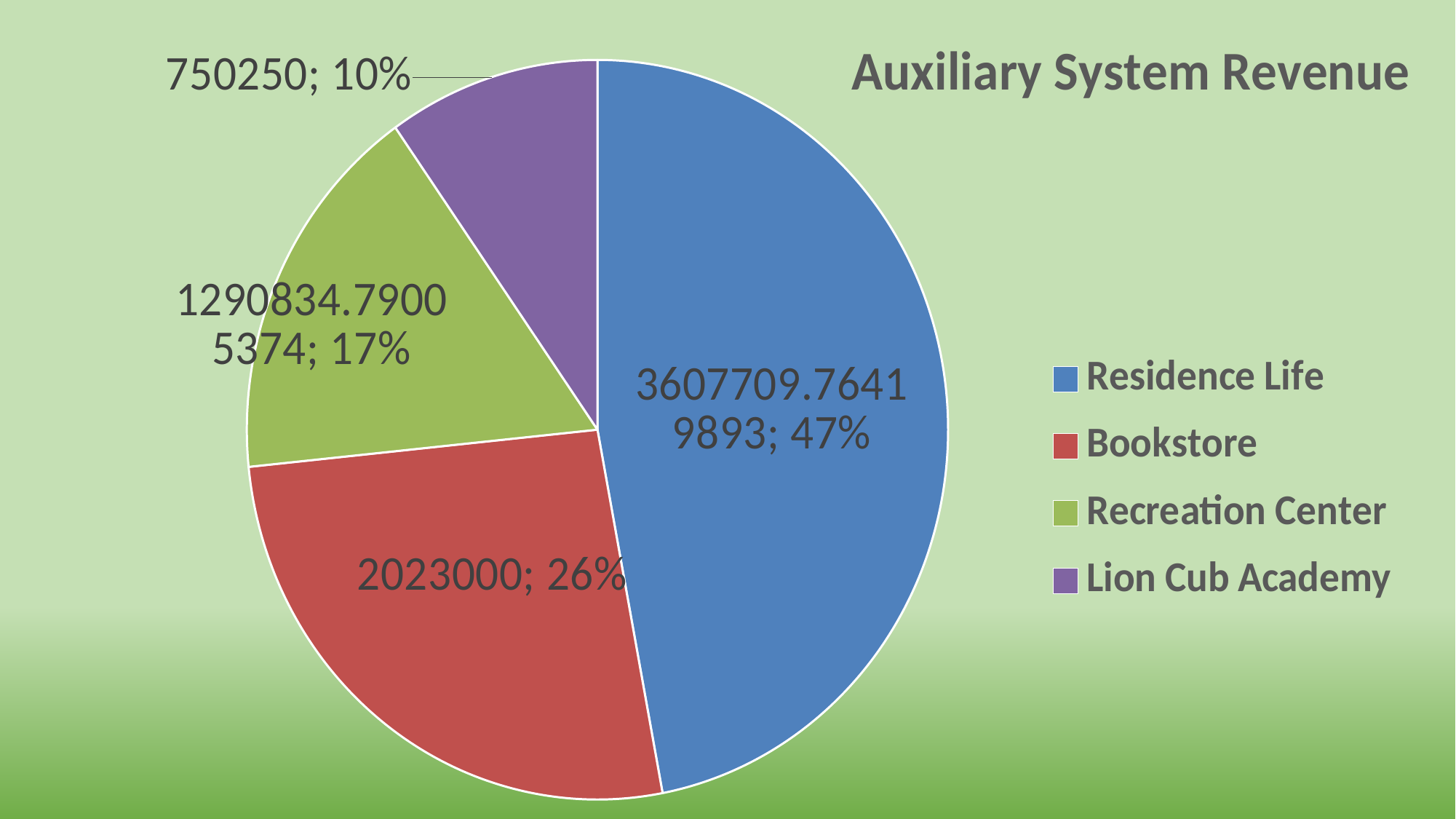
What share of the pie does Residence Life represent? 47% What kind of chart is shown on the slide? pie chart What is the revenue value shown for Bookstore? 2023000 What share of the pie does Recreation Center represent? 17% How many slices does the pie chart have? 4 Which category has the smallest slice of the pie? Lion Cub Academy What is the revenue value shown for Lion Cub Academy? 750250 What is the title of the chart? Auxiliary System Revenue What share of the pie does Lion Cub Academy represent? 10% Which category has the largest slice of the pie? Residence Life What is the difference between the Bookstore revenue and the Lion Cub Academy revenue? 1272750